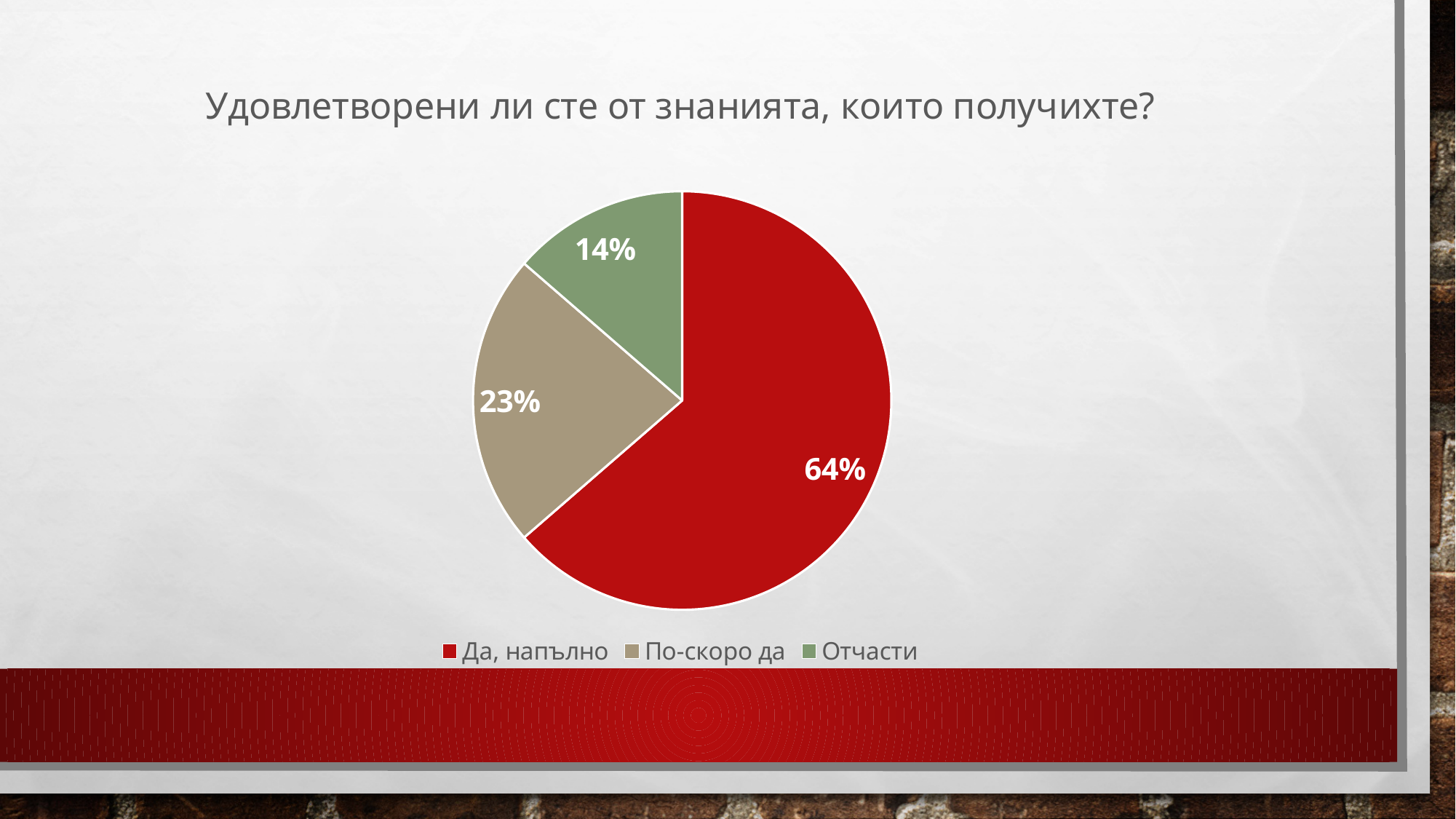
Which category has the largest slice of the pie? Да, напълно What is the difference in percentage points between "Да, напълно" and "По-скоро да"? 41 What kind of chart is shown on the slide? Pie chart What is the difference in percentage points between "По-скоро да" and "Отчасти"? 9 What share of the pie does "Отчасти" represent? 14% Which is larger, the slice for "По-скоро да" or the slice for "Отчасти"? По-скоро да What colour is the slice for "Отчасти"? Green Which category has the smallest slice of the pie? Отчасти What share of the pie does "Да, напълно" represent? 64% What share of the pie does "По-скоро да" represent? 23% What is the title of the chart? Удовлетворени ли сте от знанията, които получихте? How many categories does the pie chart show? 3